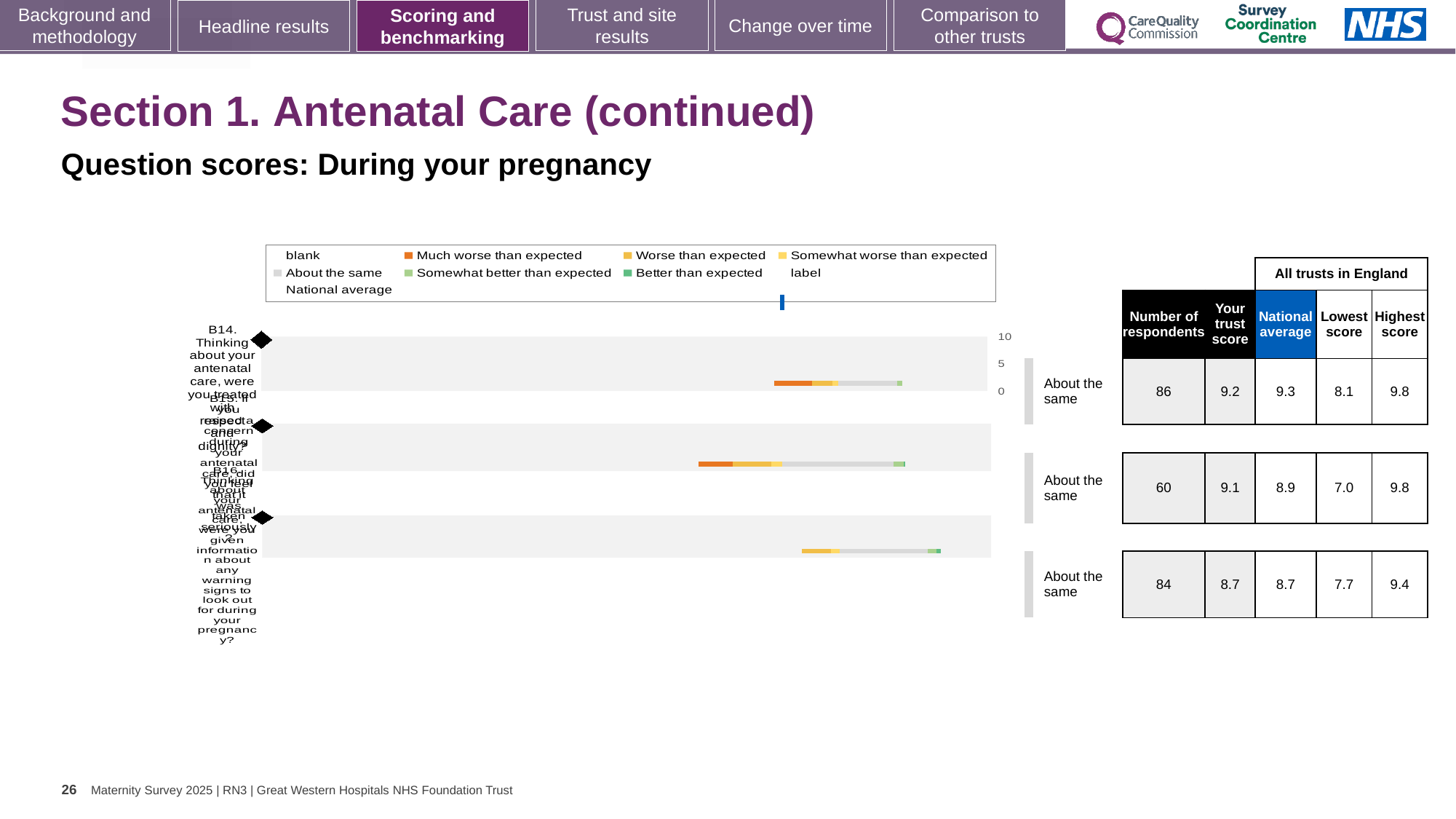
Which question has the highest 'Your trust score'? B14 (first question), 9.2 How many respondents answered the second question in the table? 60 What is the 'Your trust score' for the first question (B14, treated with respect and dignity)? 9.2 What is the difference between the highest score and the lowest score for the third question (84 respondents)? 1.7 Which question has the lowest 'Lowest score' across all trusts in England? the second question, 7.0 What kind of chart is shown on the slide? bar chart Is the trust score for the first question (B14) greater or less than 5 on the chart axis? greater For the first question (B14), which is larger: the trust score or the national average? national average (9.3) What is the national average for the first question (B14)? 9.3 What benchmark category is shown next to each of the three questions? About the same What is the highest score across all trusts in England for the third question (84 respondents)? 9.4 How many questions (bars) are plotted in the chart? 3